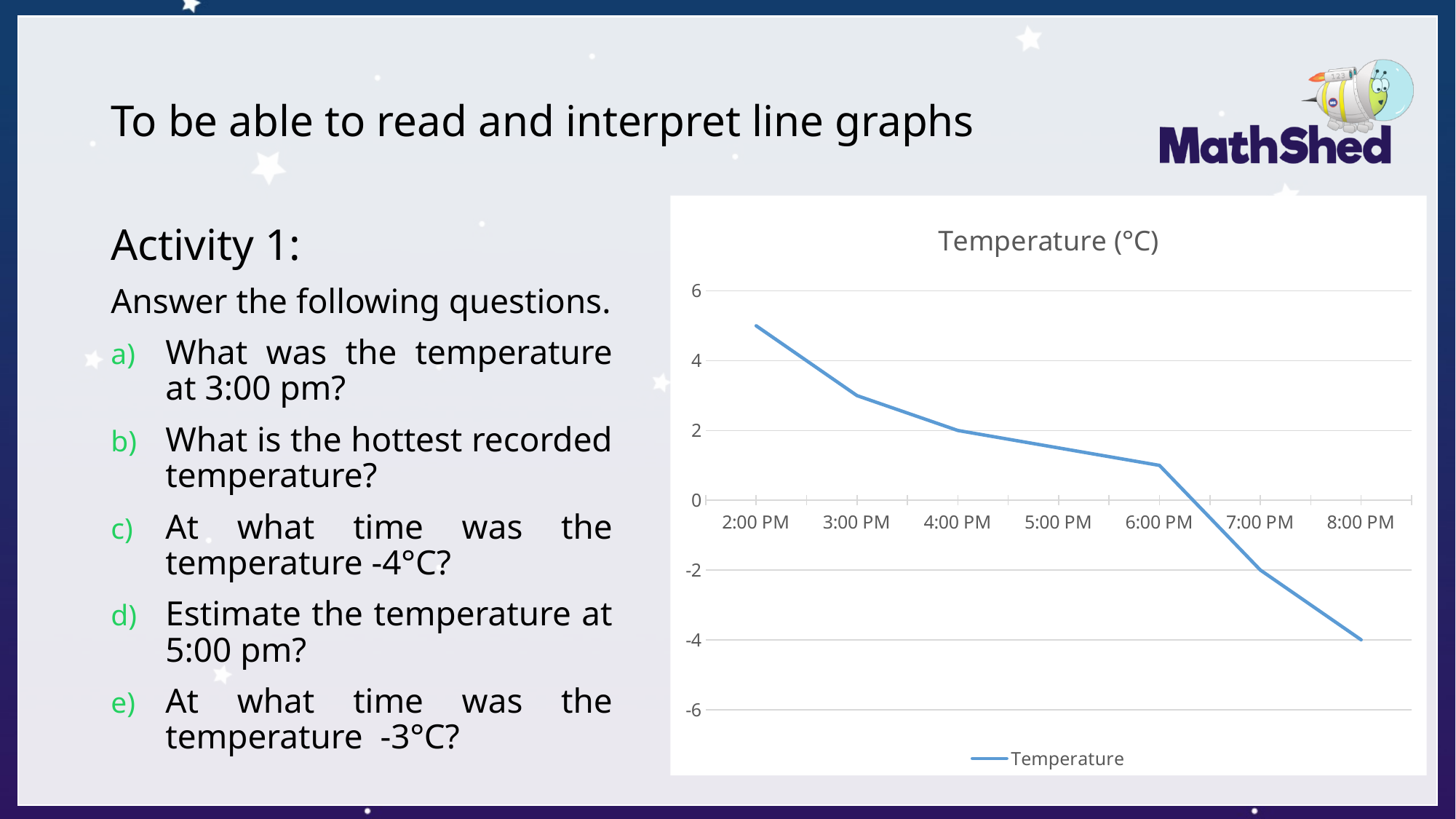
How many series does the legend list? 1 What is the difference between the temperature at 4:00 PM and at 8:00 PM? 6 At which time is the temperature lowest? 8:00 PM Is the temperature at 6:00 PM greater or less than 0? greater What type of chart is shown on the slide? line chart What is the temperature at 4:00 PM? 2 Is the temperature at 2:00 PM greater or less than 4? greater What is the temperature at 8:00 PM? -4 Does the temperature rise or fall from 2:00 PM to 8:00 PM? fall At which time is the temperature highest? 2:00 PM What is the title of the chart? Temperature (°C) How many time points are plotted on the chart? 7